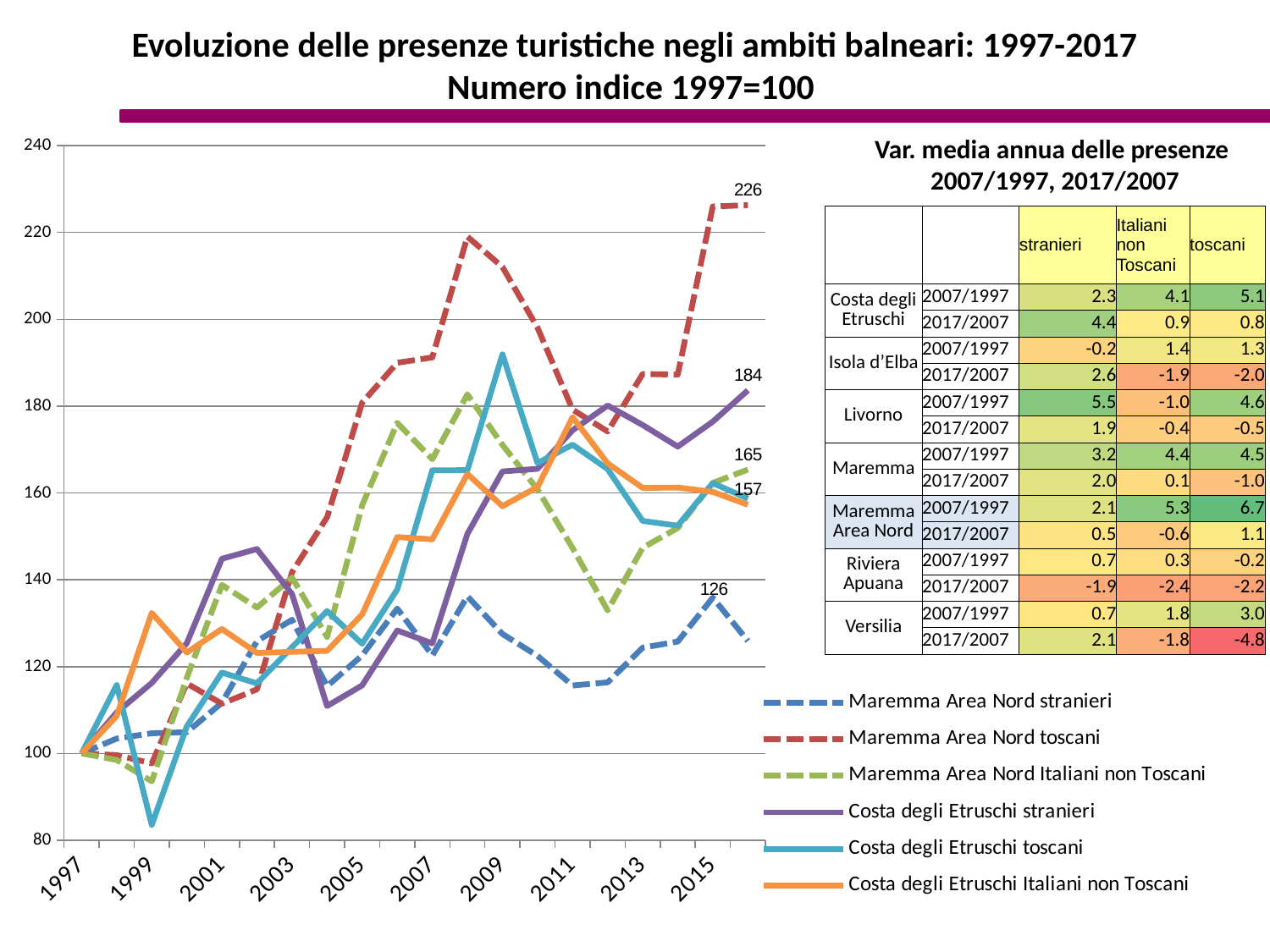
How many series does the legend of the line chart list? 6 Does the Maremma Area Nord toscani series rise or fall overall from 1997 to 2017? rise What kind of chart is shown on the left of the slide? line chart What is the 2017 value of the Maremma Area Nord Italiani non Toscani series in the line chart? 165 In the line chart, which is larger in 2017: Costa degli Etruschi stranieri or Costa degli Etruschi Italiani non Toscani? Costa degli Etruschi stranieri In the line chart, what is the difference between the 2017 values of Maremma Area Nord toscani and Costa degli Etruschi stranieri? 42 Which series has the lowest value in 2017 in the line chart? Maremma Area Nord stranieri What is the 2017 value of the Costa degli Etruschi stranieri series in the line chart? 184 What is the 2017 value of the Maremma Area Nord stranieri series in the line chart? 126 Which series has the highest value in 2017 in the line chart? Maremma Area Nord toscani What is the 2017 value of the Maremma Area Nord toscani series in the line chart? 226 In the line chart, is the 2017 value for Costa degli Etruschi toscani greater or less than 140? greater